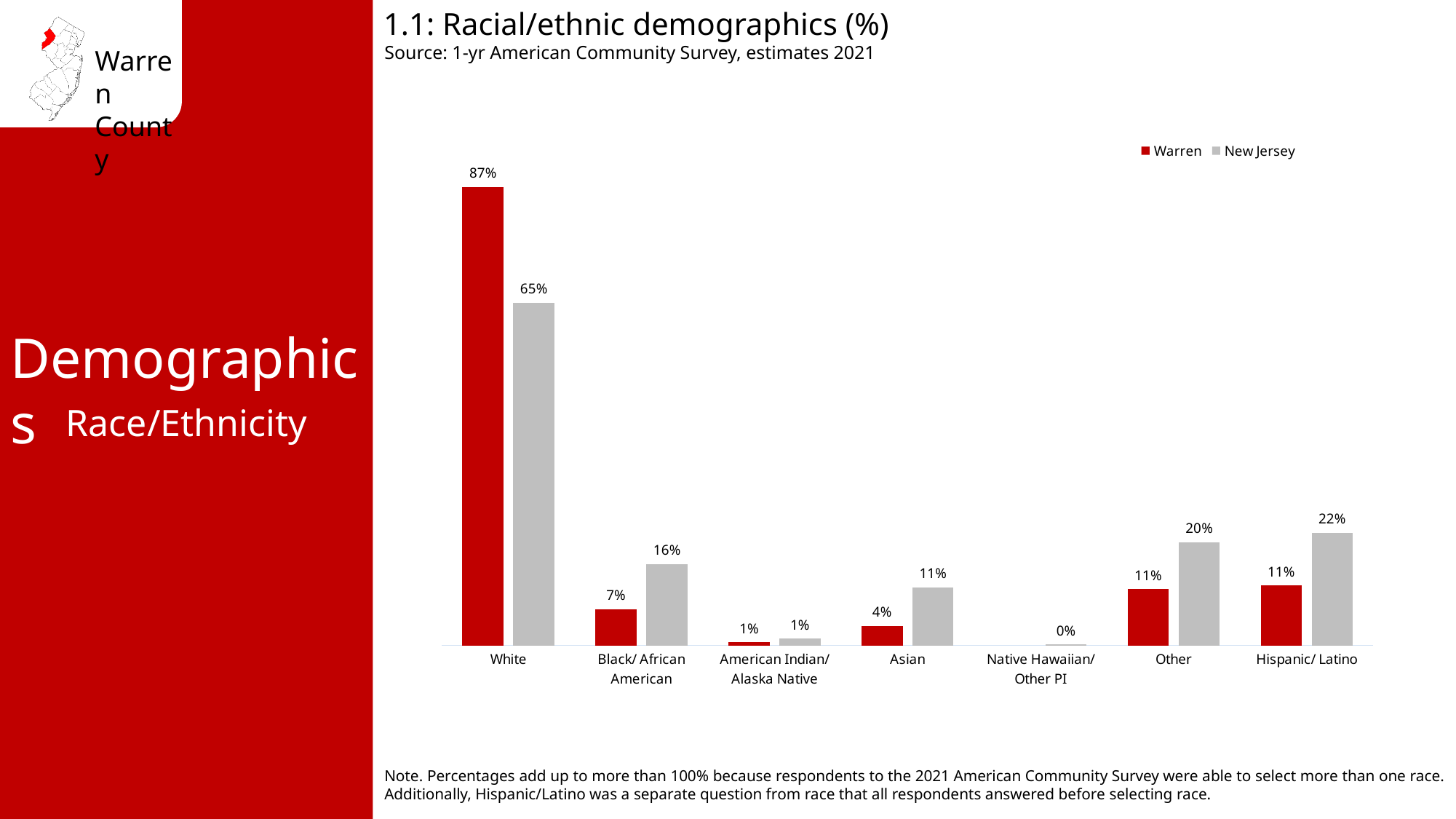
How many racial/ethnic categories are shown on the x axis? 7 What kind of chart is shown on the slide? Bar chart What is the difference between the Warren and New Jersey values for White? 22 percentage points What colour are the Warren bars? Red Which category has the highest Warren value? White What is the Warren value for Asian? 4% What is the New Jersey value for Hispanic/ Latino? 22% How many series does the legend list? 2 What is the Warren value for White? 87% Which category has the lowest New Jersey value? Native Hawaiian/ Other PI What is the New Jersey value for Other? 20% For Black/ African American, which is larger: the Warren value or the New Jersey value? New Jersey